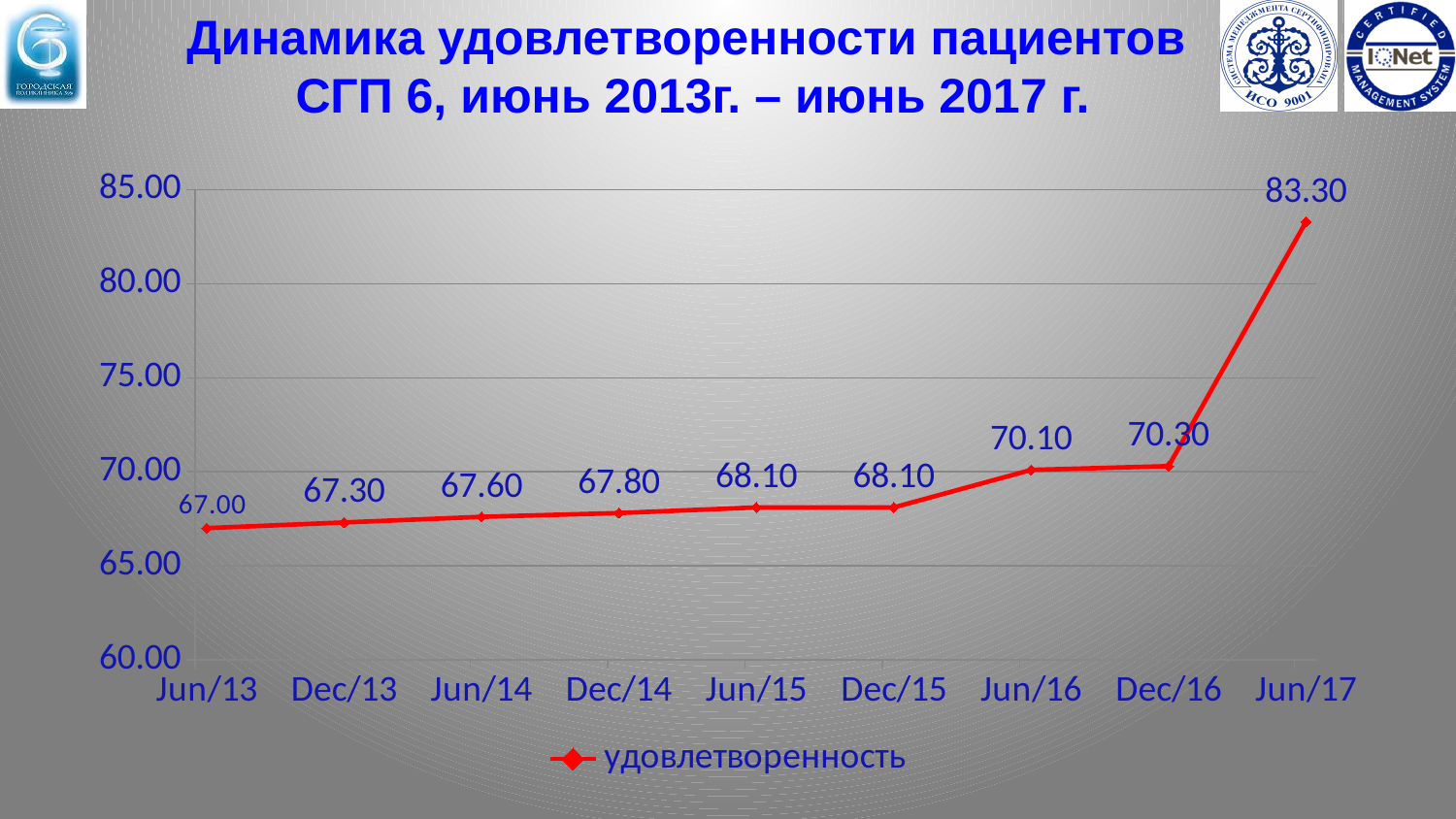
What is the difference between the values for Jun/16 and Dec/15? 2.00 How many data points are plotted on the chart? 9 Which point has the highest value? Jun/17 What is the value for Jun/13? 67.00 Which is larger, the value for Jun/16 or the value for Jun/15? Jun/16 What is the value for Dec/14? 67.80 Is the value for Dec/16 greater or less than 75.00? less Do the values rise or fall from Jun/13 to Jun/17? rise What kind of chart is shown on the slide? line chart What is the value for Jun/17? 83.30 What is the difference between the values for Jun/17 and Dec/16? 13.00 Which point has the lowest value? Jun/13